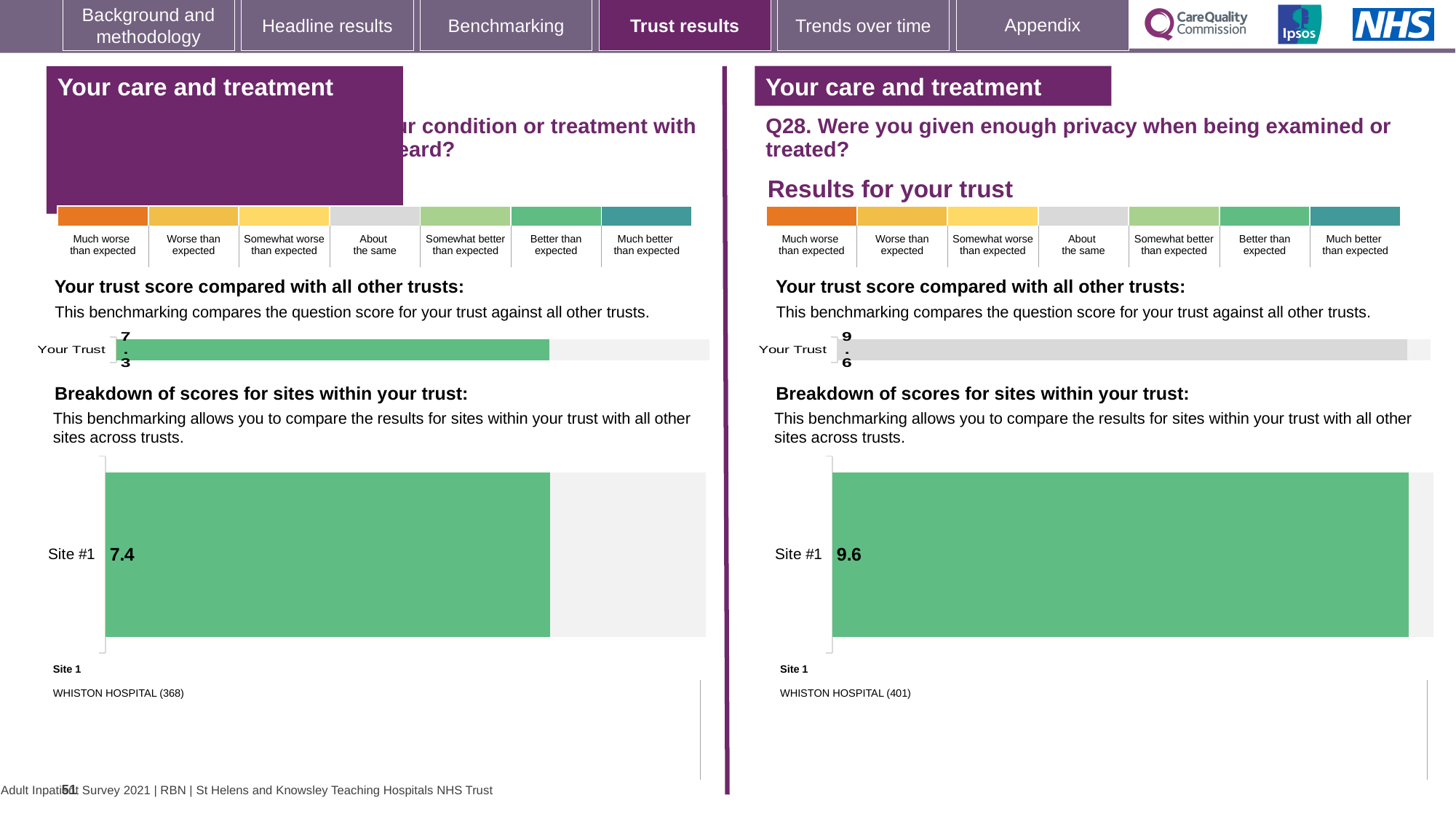
On the left-hand chart, what is the trust score shown for 'Your Trust'? 7.3 How many benchmark categories are shown in the colour key above the left-hand trust score chart? 7 How many sites are shown in the right-hand Q28 site breakdown chart? 1 On the right-hand chart for Q28 (privacy when being examined or treated), what is the trust score shown for 'Your Trust'? 9.6 What kind of chart is used to show the Site #1 score on the left-hand side of the slide? Bar chart On the left-hand side, what is the difference between the Site #1 score (7.4) and the 'Your Trust' score (7.3)? 0.1 On the left-hand site breakdown chart, what score is shown for Site #1? 7.4 What is the difference between the Site #1 score on the right-hand Q28 chart (9.6) and the Site #1 score on the left-hand chart (7.4)? 2.2 How many sites are shown in the left-hand site breakdown chart? 1 Which site name is listed under Site 1 on the right-hand Q28 chart? WHISTON HOSPITAL (401) On the right-hand Q28 site breakdown chart, what score is shown for Site #1? 9.6 Which is larger: the Site #1 score on the left-hand chart or the Site #1 score on the right-hand Q28 chart? Right-hand Q28 chart (9.6)